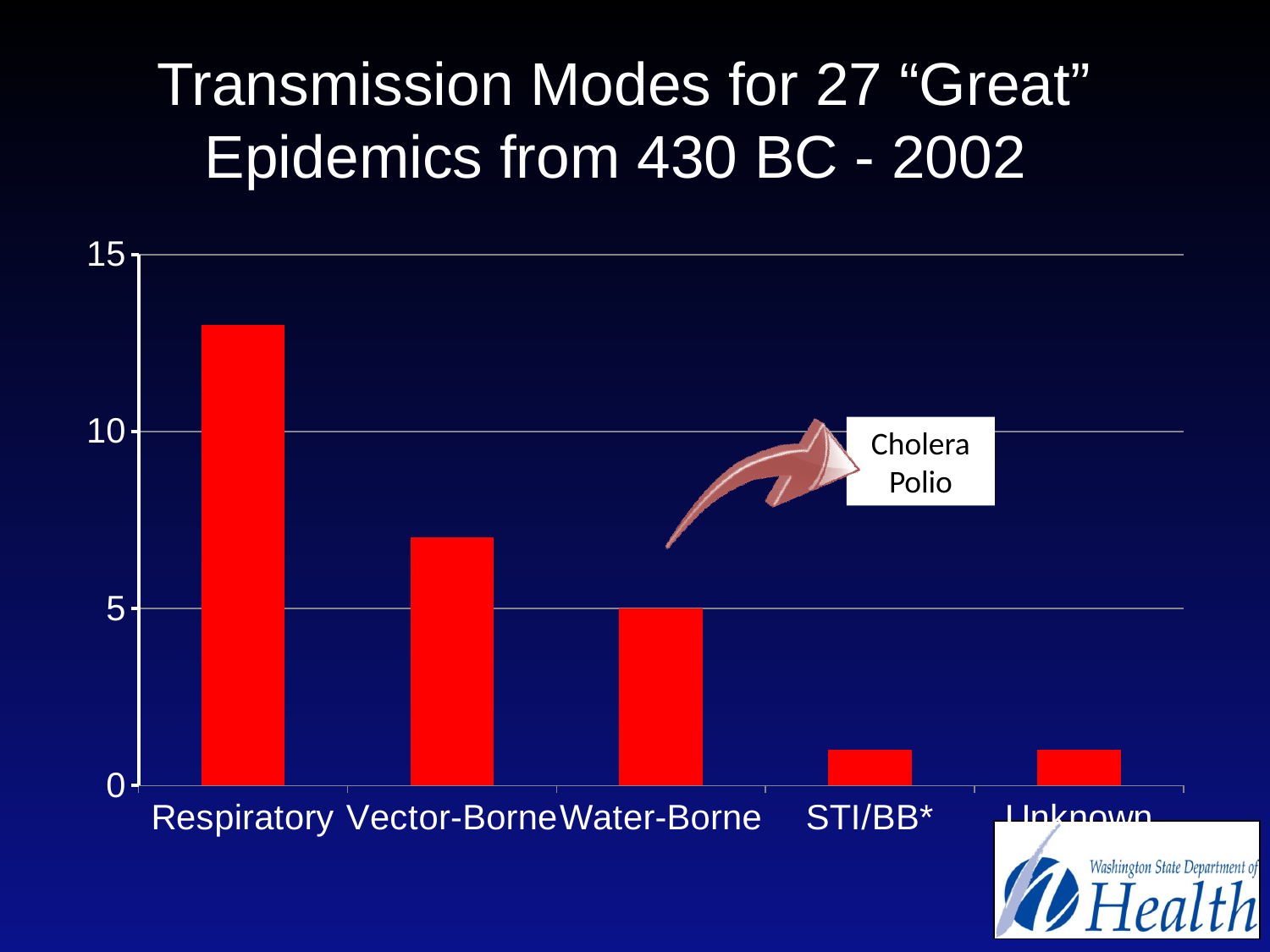
What is the title of the chart? Transmission Modes for 27 "Great" Epidemics from 430 BC - 2002 Which is larger, the value for Water-Borne or the value for STI/BB*? Water-Borne What kind of chart is shown on the slide? bar chart Is the value for Vector-Borne greater or less than 5? greater Is the value for Respiratory greater or less than 10? greater Is the value for STI/BB* greater or less than 5? less Which is larger, the value for Respiratory or the value for Vector-Borne? Respiratory Which two diseases are named in the callout box pointing at the Water-Borne bar? Cholera and Polio What is the value for Water-Borne? 5 How many transmission mode categories are shown on the x axis? 5 Which transmission mode has the highest number of epidemics? Respiratory